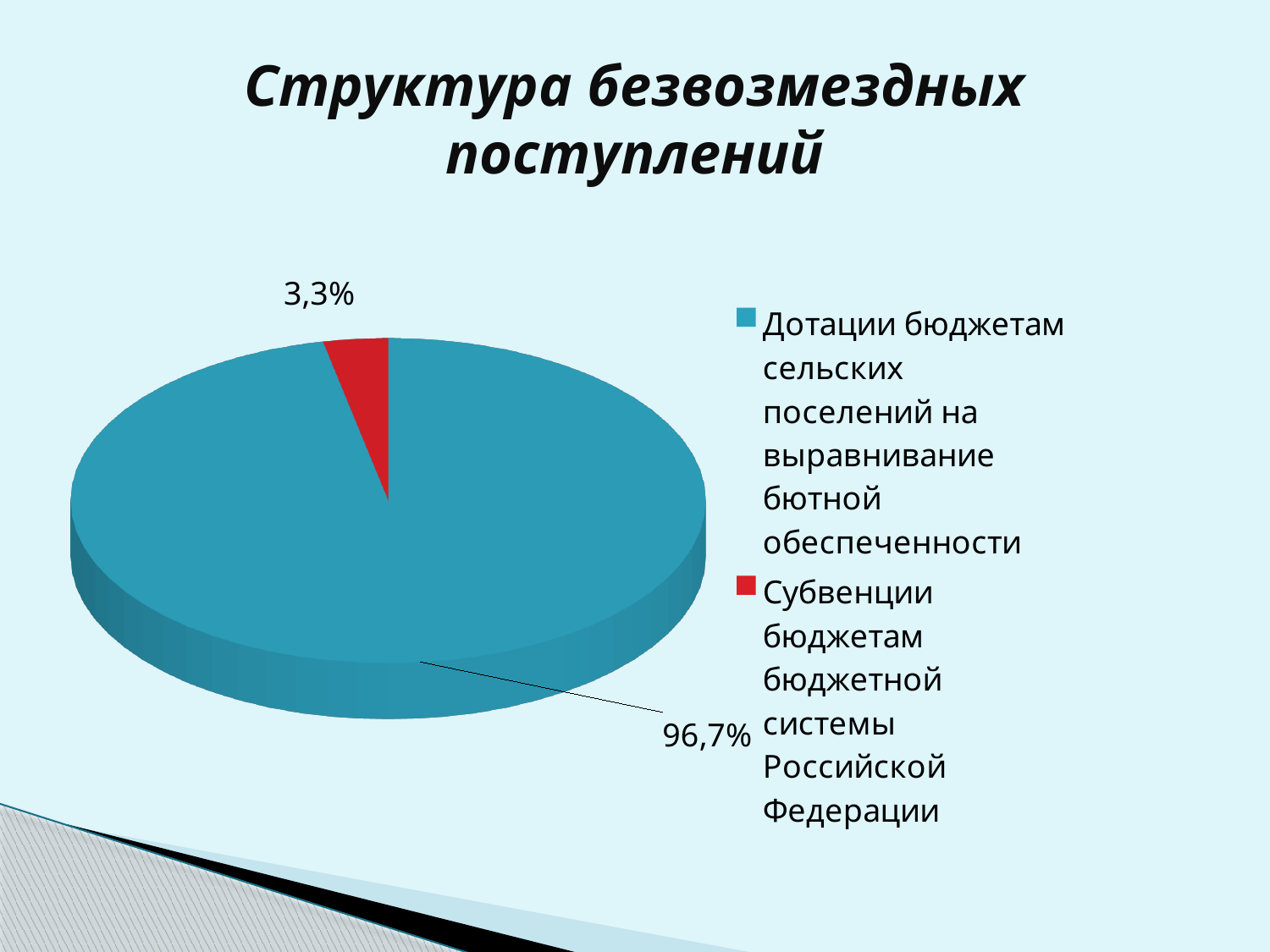
What is the title of the chart on the slide? Структура безвозмездных поступлений Which category has the smallest slice of the pie? Субвенции бюджетам бюджетной системы Российской Федерации How many entries does the legend list? 2 What kind of chart is shown on the slide? Pie chart What share of the pie is labelled for Субвенции бюджетам бюджетной системы Российской Федерации? 3,3% Which category has the largest slice of the pie? Дотации бюджетам сельских поселений на выравнивание бютной обеспеченности How many slices does the pie chart have? 2 Which is larger: the slice for Дотации or the slice for Субвенции? Дотации What is the difference in percentage points between the two slices of the pie? 93,4 What share of the pie is labelled for Дотации бюджетам сельских поселений на выравнивание бютной обеспеченности? 96,7% What colour is the slice for Субвенции бюджетам бюджетной системы Российской Федерации? Red